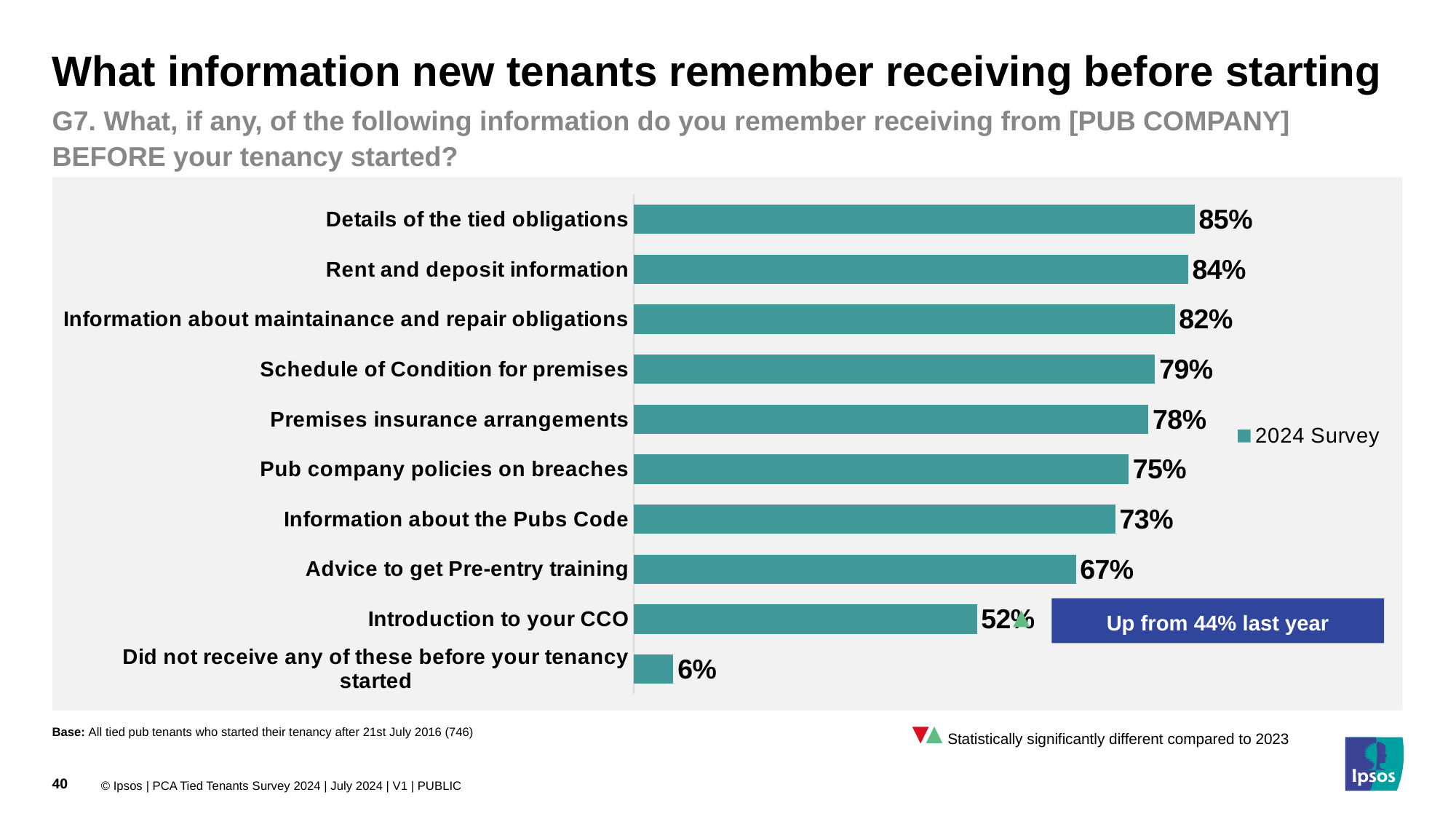
What percentage of new tenants remember receiving details of the tied obligations? 85% What series name is shown in the legend? 2024 Survey How many categories are shown in the chart? 10 What percentage did not receive any of these before their tenancy started? 6% What is the difference between 'Rent and deposit information' and 'Information about the Pubs Code'? 11 percentage points Which category has the lowest value? Did not receive any of these before your tenancy started What is the value for 'Advice to get Pre-entry training'? 67% How many series does the legend list? 1 Which category has the highest value? Details of the tied obligations What is the value for 'Introduction to your CCO'? 52% What kind of chart is shown on the slide? Bar chart Which is larger: 'Schedule of Condition for premises' or 'Pub company policies on breaches'? Schedule of Condition for premises